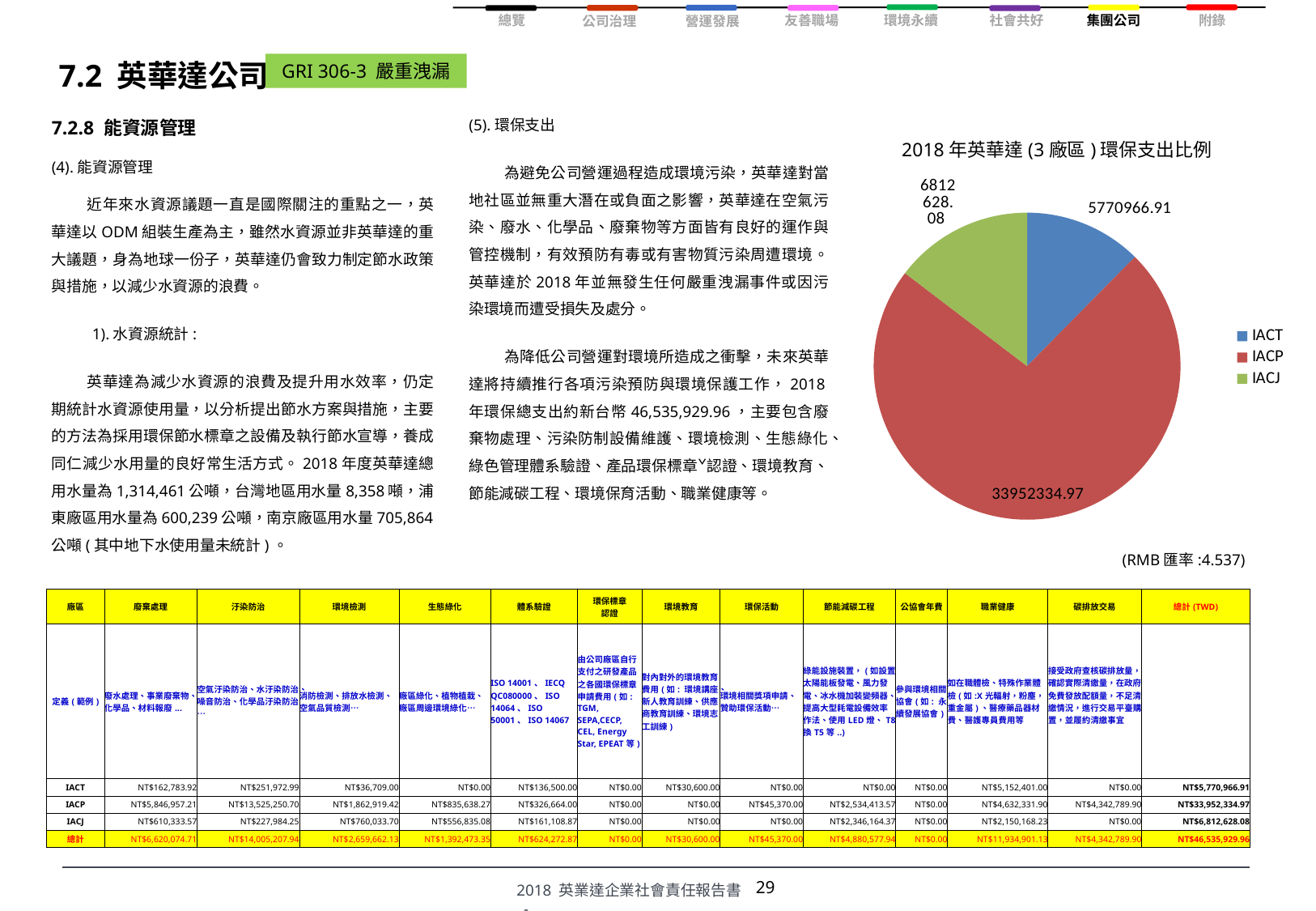
What is the total of the three values shown in the pie chart? 46535929.96 What is the value shown for IACP in the pie chart? 33952334.97 How many slices does the pie chart have? 3 What type of chart is shown on the slide? pie chart What is the value shown for IACJ in the pie chart? 6812628.08 How many entries does the pie chart's legend list? 3 What is the value shown for IACT in the pie chart? 5770966.91 What is the title of the pie chart? 2018 年英華達 (3 廠區 ) 環保支出比例 Which plant has the largest slice in the pie chart? IACP What is the difference between the IACP value and the IACT value in the pie chart? 28181368.06 Which plant has the smallest slice in the pie chart? IACT In the pie chart, which is larger, the value for IACJ or the value for IACT? IACJ